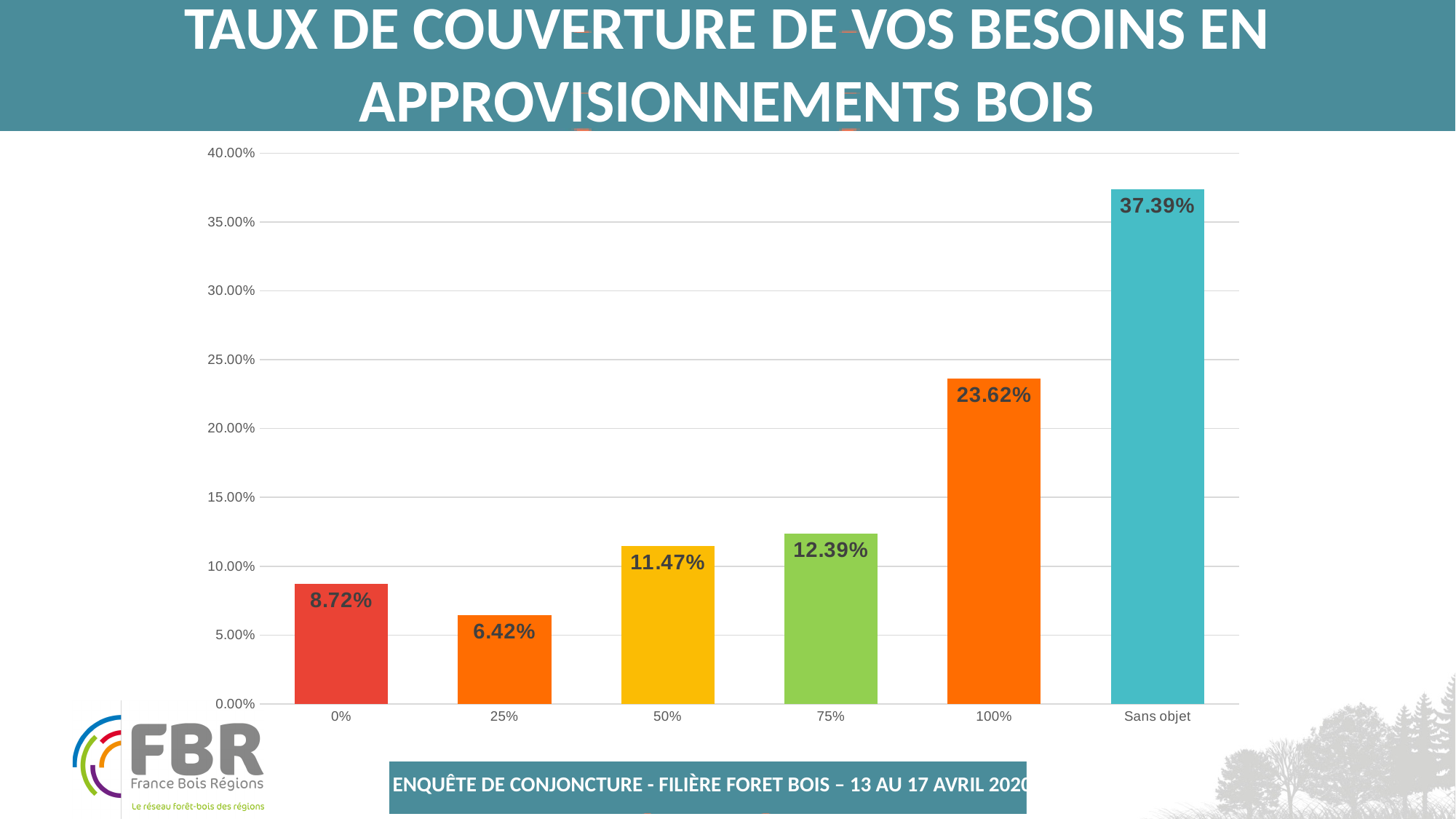
What is the value for the "0%" category? 8.72% How many categories are shown on the x axis? 6 What kind of chart is shown on the slide? bar chart Which category has the highest value? Sans objet Which is larger, the value for "0%" or the value for "25%"? 0% Which category has the lowest value? 25% Is the value for "100%" greater or less than 20.00%? greater What is the difference between the values for "Sans objet" and "100%"? 13.77% What is the value for the "Sans objet" category? 37.39% What is the difference between the values for "75%" and "50%"? 0.92% What is the value for the "25%" category? 6.42% What is the value for the "100%" category? 23.62%